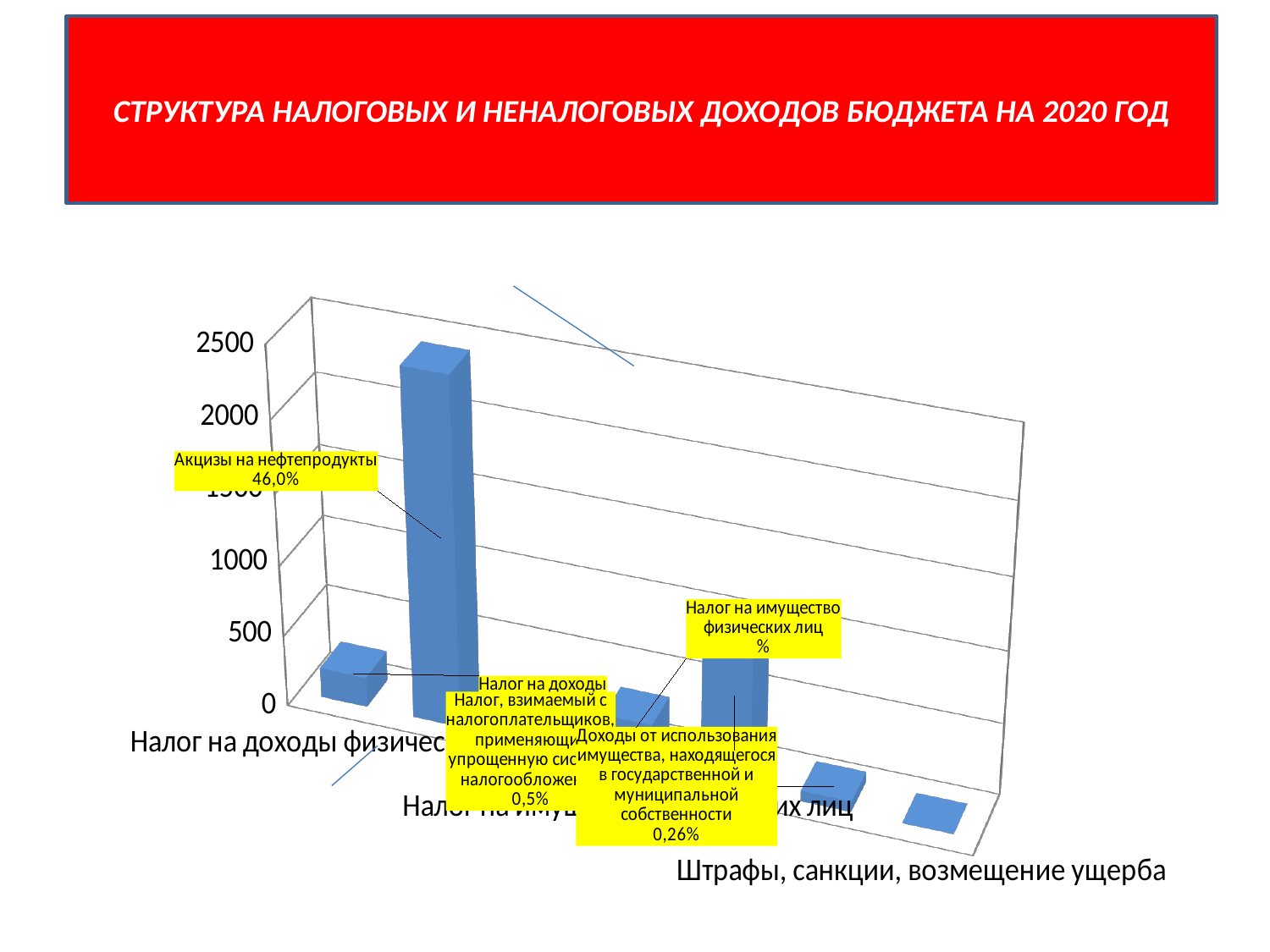
What is the highest tick value shown on the vertical axis of the chart? 2500 Is the value for Акцизы на нефтепродукты greater or less than 2000? greater Which is larger: the bar for Акцизы на нефтепродукты or the bar for Налог на доходы физических лиц? Акцизы на нефтепродукты What kind of chart is shown on the slide? bar chart What share is shown in the label for Налог, взимаемый с налогоплательщиков, применяющих упрощенную систему налогообложения? 0,5% Which category has the highest bar in the chart? Акцизы на нефтепродукты What share is shown in the label for Акцизы на нефтепродукты? 46,0% Is the value for Налог на доходы физических лиц greater or less than 500? less What is the title of the slide containing the chart? СТРУКТУРА НАЛОГОВЫХ И НЕНАЛОГОВЫХ ДОХОДОВ БЮДЖЕТА НА 2020 ГОД What share is shown in the label for Доходы от использования имущества, находящегося в государственной и муниципальной собственности? 0,26%